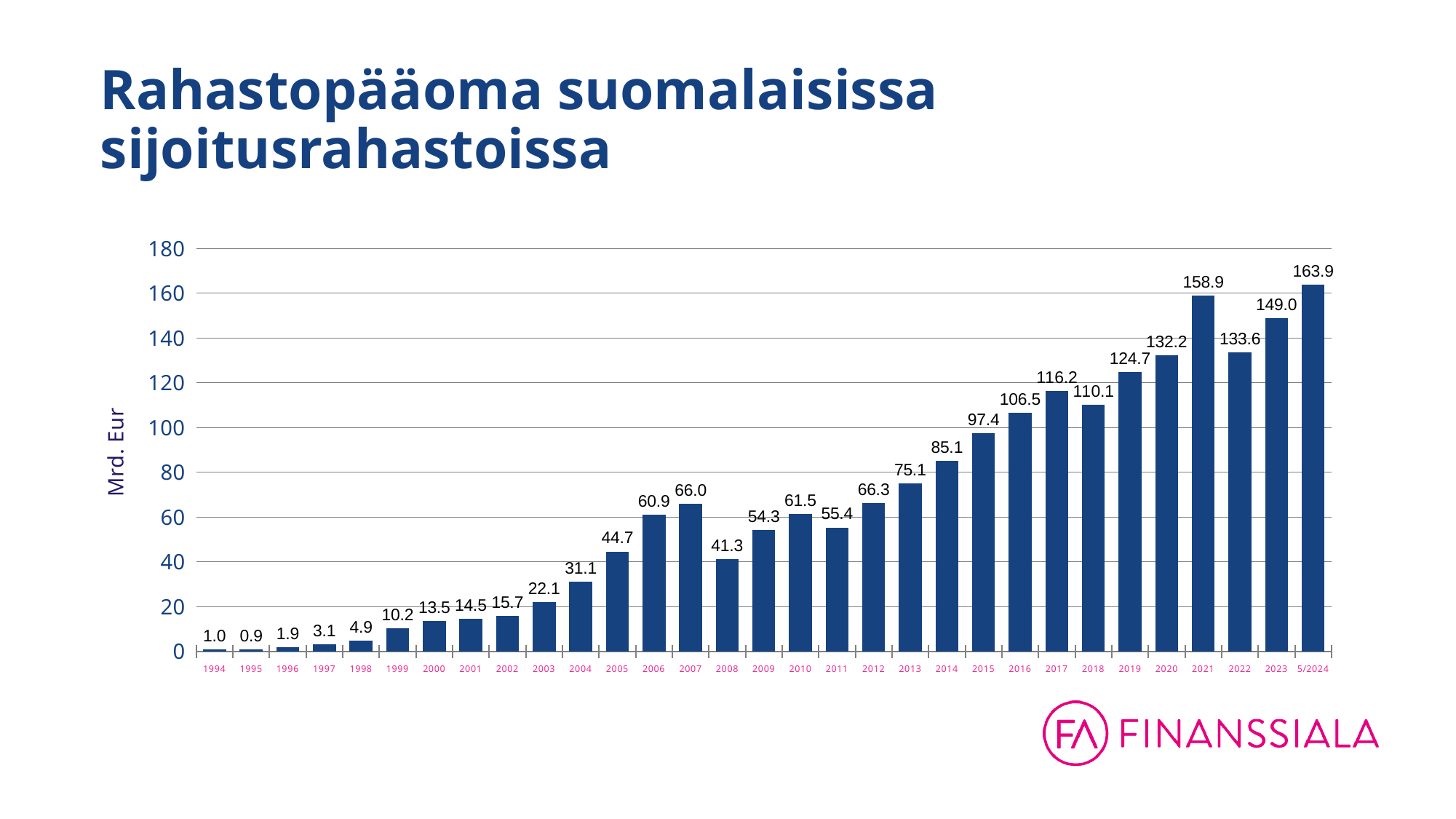
What is the label of the vertical axis? Mrd. Eur How many bars are shown in the chart? 31 What is the difference between the values for 2021 and 2022? 25.3 What is the difference between the values for 2007 and 2008? 24.7 Which is larger, the value for 2017 or the value for 2018? 2017 What is the value for 2021? 158.9 Is the value for 2015 greater or less than 100? less What kind of chart is shown on the slide? bar chart Which year has the highest value? 5/2024 What is the value for 5/2024? 163.9 What is the value for 2008? 41.3 Which year has the lowest value? 1995